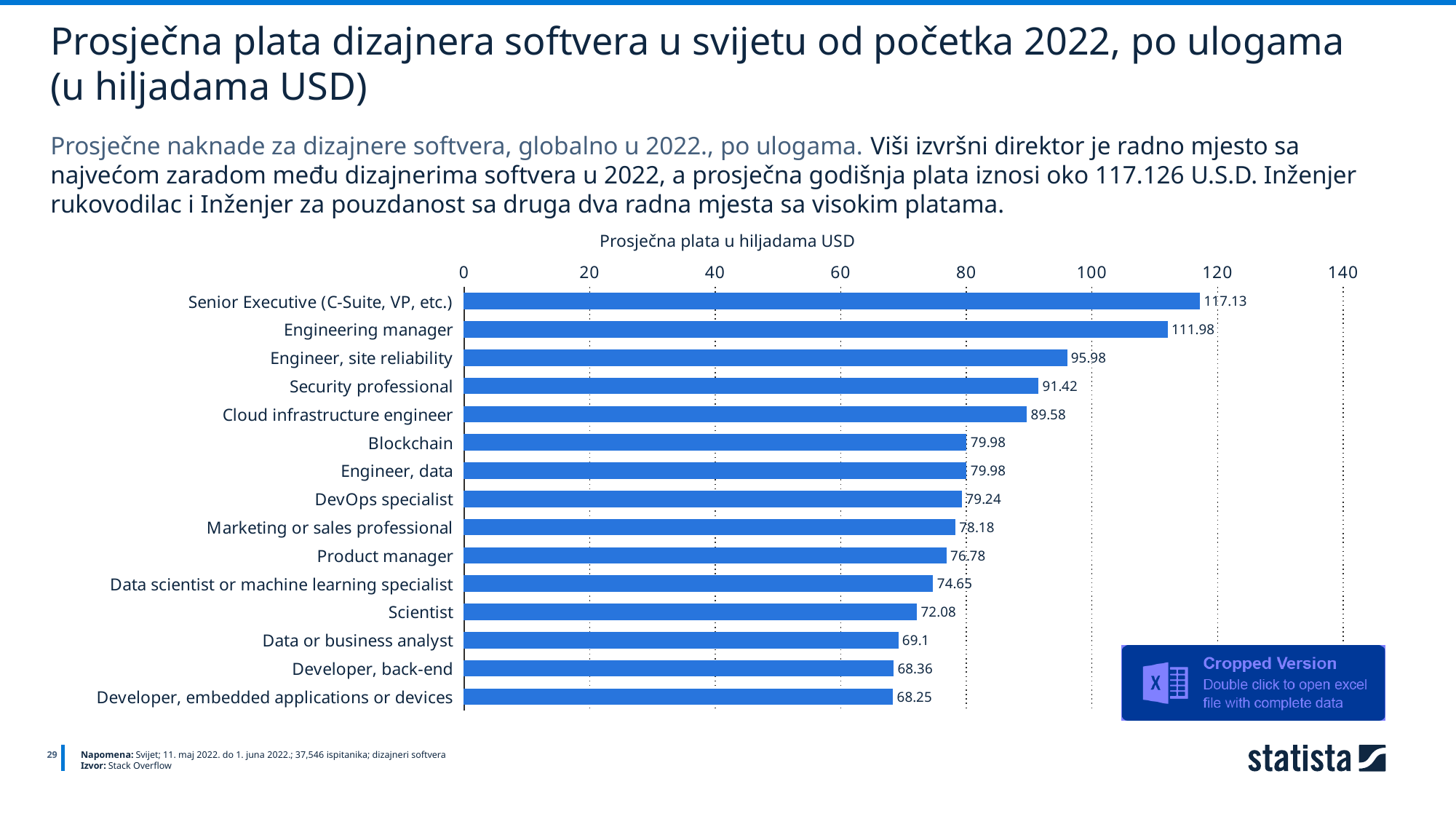
What is the difference between the values for Scientist and Data or business analyst? 2.98 Which is larger, the value for Engineer, site reliability or for Security professional? Engineer, site reliability What is the average salary shown for Engineering manager? 111.98 What is the difference between the values for Senior Executive (C-Suite, VP, etc.) and Engineering manager? 5.15 Is the value for Product manager greater or less than 80? less Which role has the lowest average salary in the chart? Developer, embedded applications or devices Which role has the highest average salary in the chart? Senior Executive (C-Suite, VP, etc.) What kind of chart is shown on the slide? bar chart What is the title printed above the chart? Prosječna plata u hiljadama USD What value is shown for Cloud infrastructure engineer? 89.58 What is the value for Data or business analyst? 69.1 How many roles are shown in the chart? 15